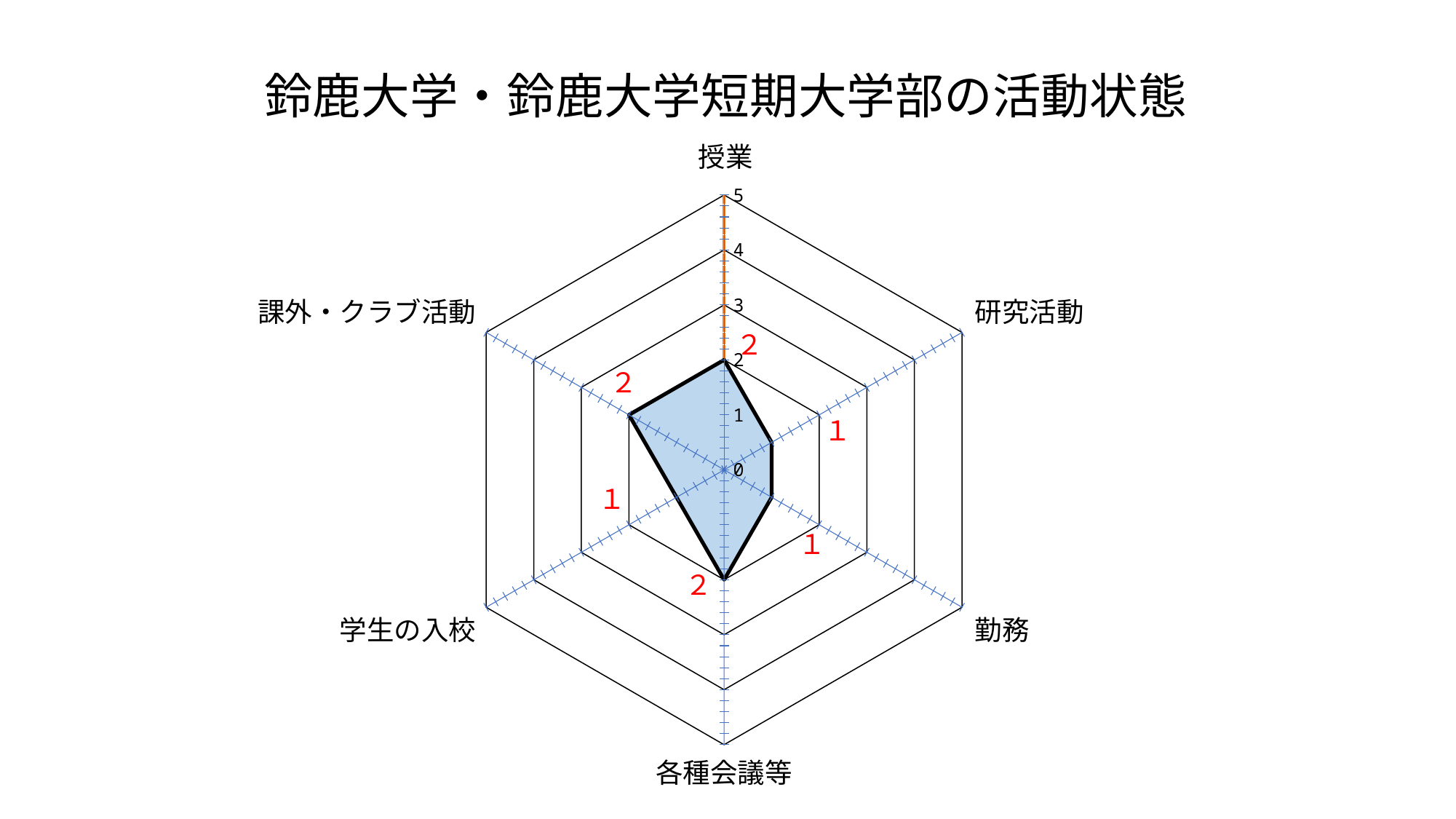
What is the title of the slide? 鈴鹿大学・鈴鹿大学短期大学部の活動状態 What is the difference between the value for 各種会議等 and the value for 勤務? 1 What kind of chart is shown on the slide? radar chart What is the value for 授業? 2 What is the value for 学生の入校? 1 Which is larger, the value for 授業 or the value for 研究活動? 授業 What is the value for 研究活動? 1 How many categories (axes) does the radar chart have? 6 What is the value for 各種会議等? 2 What is the value for 勤務? 1 Is the value for 課外・クラブ活動 greater or less than 3? less What is the value for 課外・クラブ活動? 2